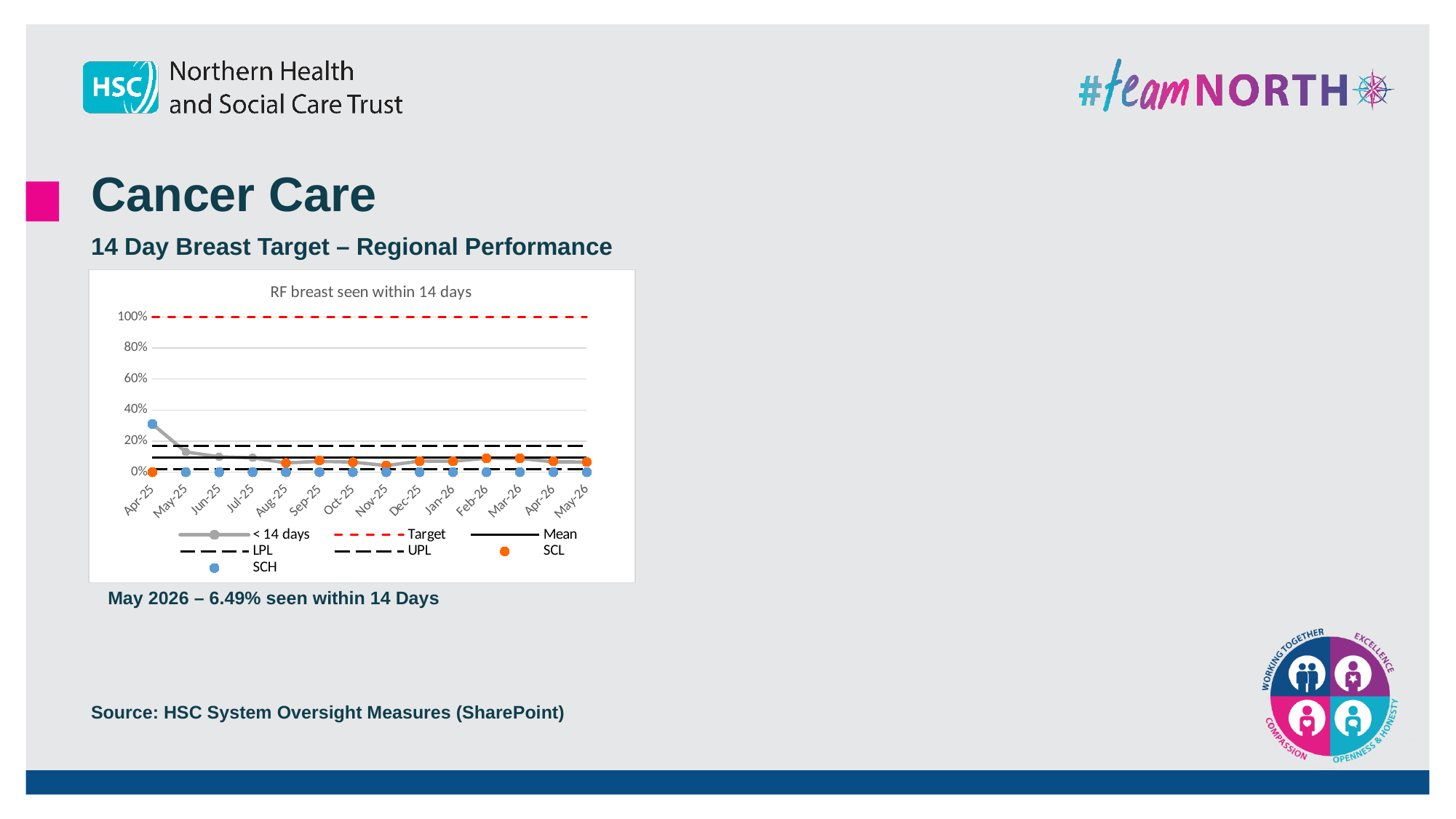
Which month has the highest value for the '< 14 days' series? Apr-25 At what level is the Target line drawn on the chart? 100% Is the '< 14 days' value for Nov-25 greater or less than 20%? less Which of the two is larger: the '< 14 days' value for Apr-25 or for Jun-25? Apr-25 Is the '< 14 days' value for May-25 greater or less than 20%? less What percentage was seen within 14 days in May 2026, according to the slide? 6.49% What is the title of the chart? RF breast seen within 14 days How many months are plotted along the x axis of the chart? 14 Is the '< 14 days' value for Apr-25 greater or less than 20%? greater How many series does the chart legend list? 7 What kind of chart is shown on the slide? line chart Does the '< 14 days' series rise or fall between Apr-25 and Jul-25? fall